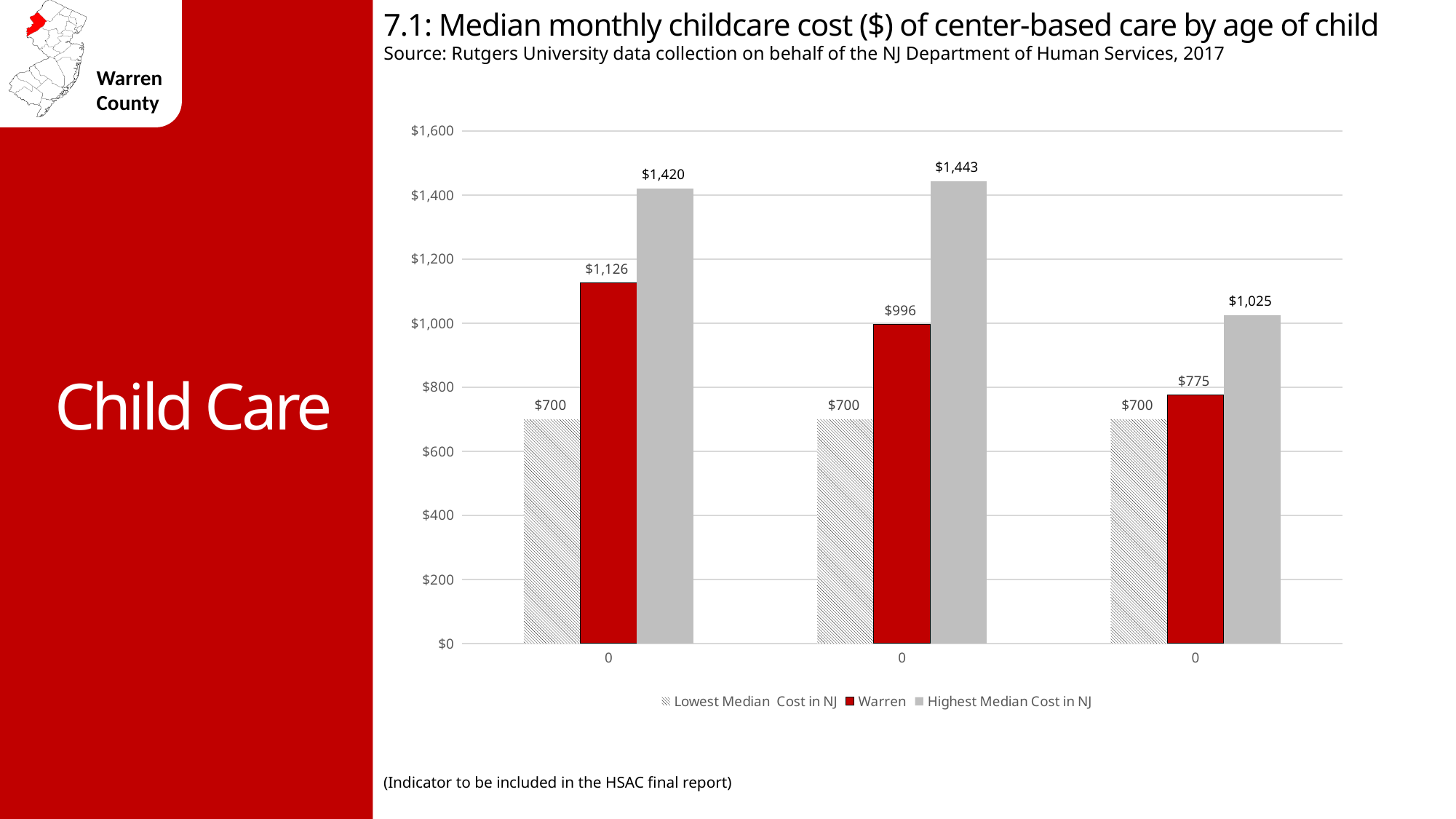
Which group of bars has the lowest Highest Median Cost in NJ value? The third (rightmost) group In the second group of bars, which is larger: the Warren value or the Highest Median Cost in NJ value? Highest Median Cost in NJ What is the difference between the Highest Median Cost in NJ and the Warren value in the first group of bars? $294 How many series does the legend list? 3 Is the Warren value in the second group of bars greater or less than $1,000? less Which series is drawn in red? Warren What is the Lowest Median Cost in NJ value in the third group of bars? $700 What is the Highest Median Cost in NJ value in the second group of bars? $1,443 What is the Warren value in the first group of bars from the left? $1,126 What is the Warren value in the third (rightmost) group of bars? $775 Which group of bars has the highest Warren value? The first group from the left What kind of chart is shown on the slide? Bar chart